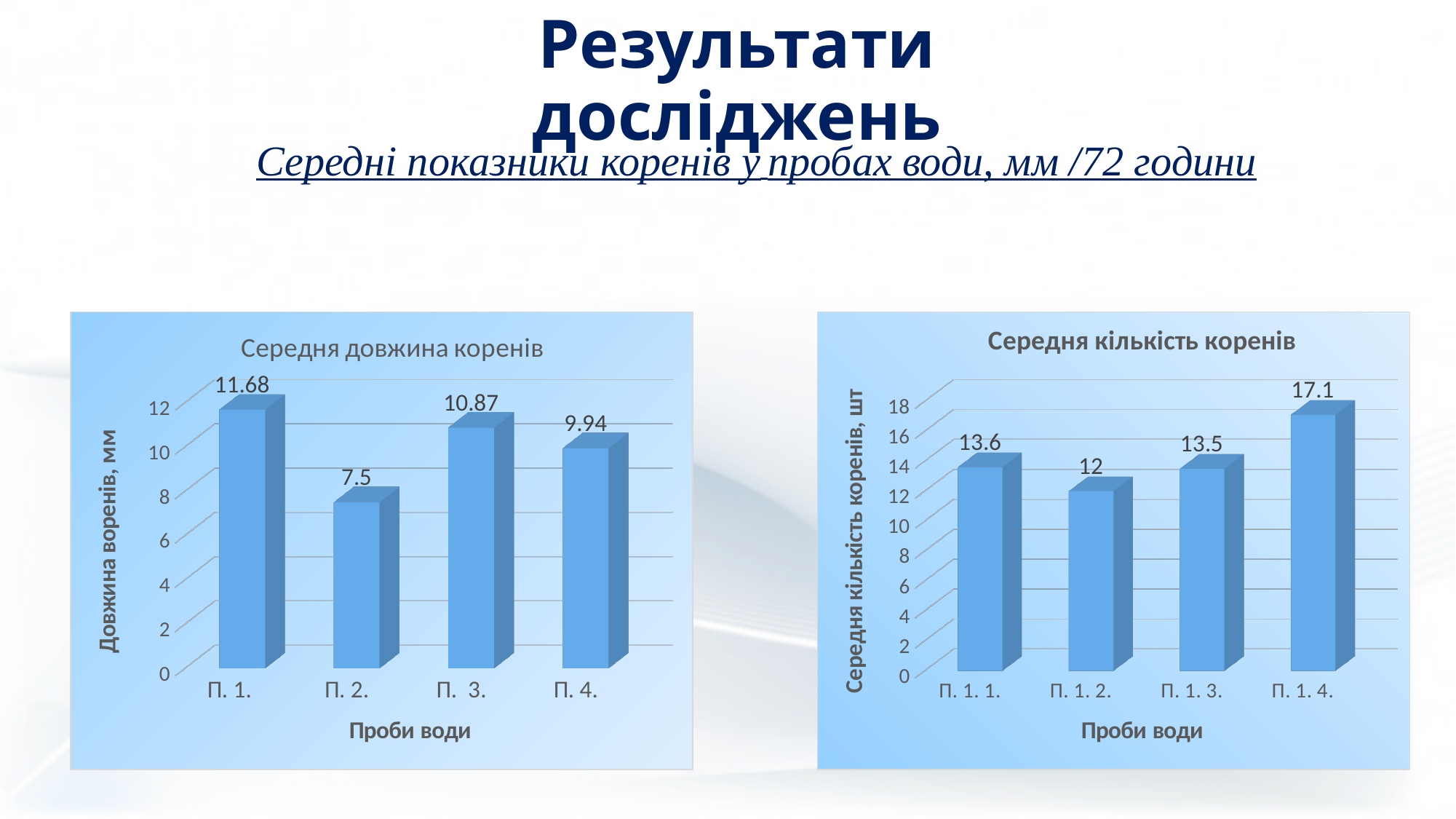
In the chart titled "Середня кількість коренів", what is the value for П. 1. 4.? 17.1 In the chart titled "Середня довжина коренів", how many categories are shown on the x axis? 4 In the chart titled "Середня кількість коренів", which category has the highest value? П. 1. 4. What is the y-axis label of the chart titled "Середня довжина коренів"? Довжина воренів, мм In the chart titled "Середня довжина коренів", which is larger: the value for П. 3. or the value for П. 4.? П. 3. In the chart titled "Середня довжина коренів", what is the difference between the values for П. 1. and П. 2.? 4.18 In the chart titled "Середня кількість коренів", what is the difference between the values for П. 1. 4. and П. 1. 2.? 5.1 In the chart titled "Середня кількість коренів", which category has the lowest value? П. 1. 2. In the chart titled "Середня довжина коренів", what is the value for П. 1.? 11.68 What kind of chart is the chart titled "Середня кількість коренів"? bar chart In the chart titled "Середня довжина коренів", which category has the lowest value? П. 2. In the chart titled "Середня кількість коренів", what is the value for П. 1. 3.? 13.5